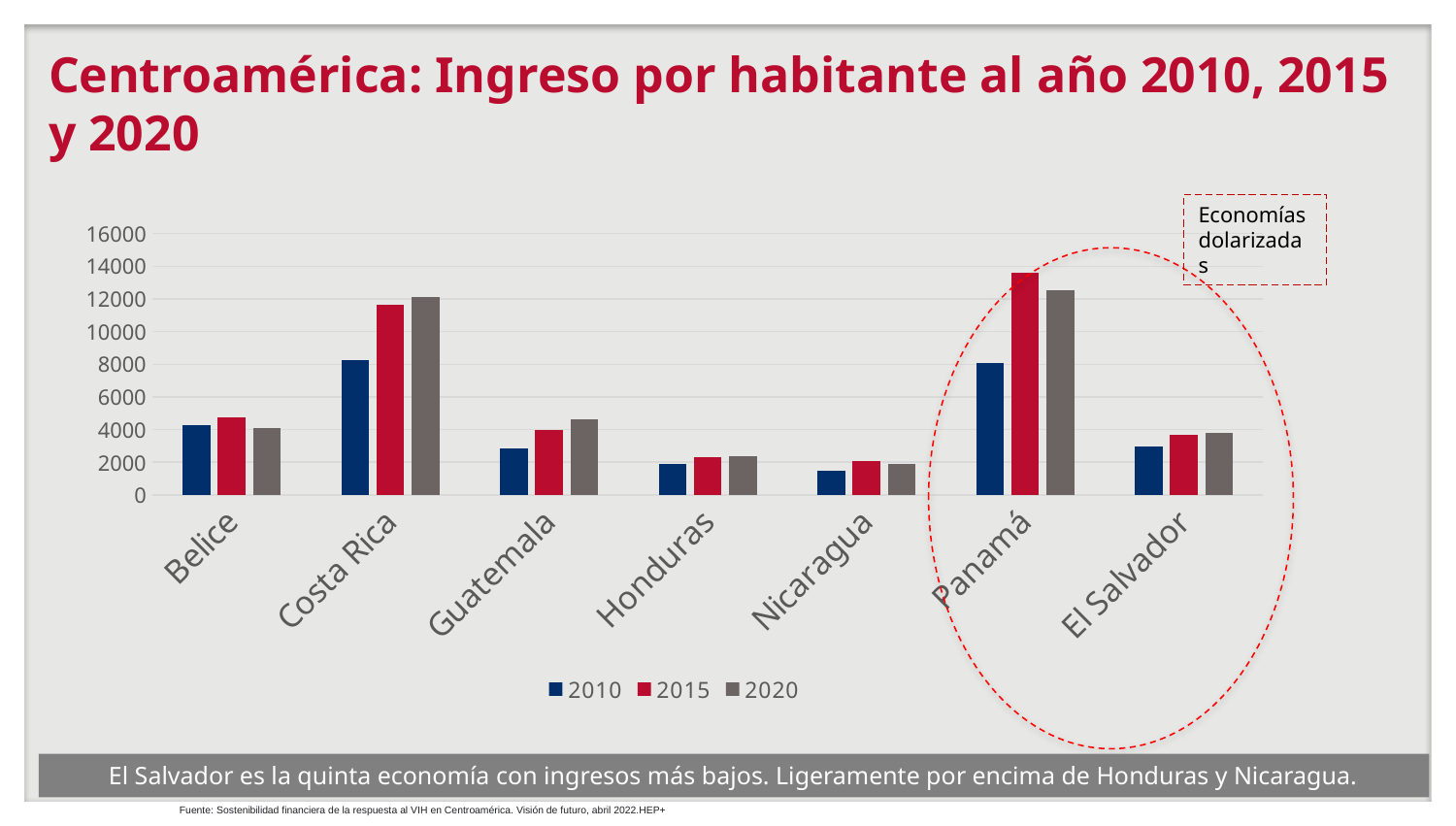
Is the 2015 value for Honduras greater or less than 4000? less Do the values for Costa Rica rise or fall from 2010 to 2020? rise Which is larger, the 2015 value for Costa Rica or the 2015 value for Belice? Costa Rica Which is larger, the 2020 value for Guatemala or the 2020 value for Nicaragua? Guatemala How many countries are shown on the x axis of the chart? 7 Which country has the lowest value for 2010? Nicaragua How many series does the legend list? 3 Is the 2020 value for Costa Rica greater or less than 10000? greater What kind of chart is shown on the slide? bar chart Which country has the highest value for 2015? Panamá What are the entries listed in the chart legend? 2010, 2015, 2020 Is the 2015 value for Panamá greater or less than 12000? greater